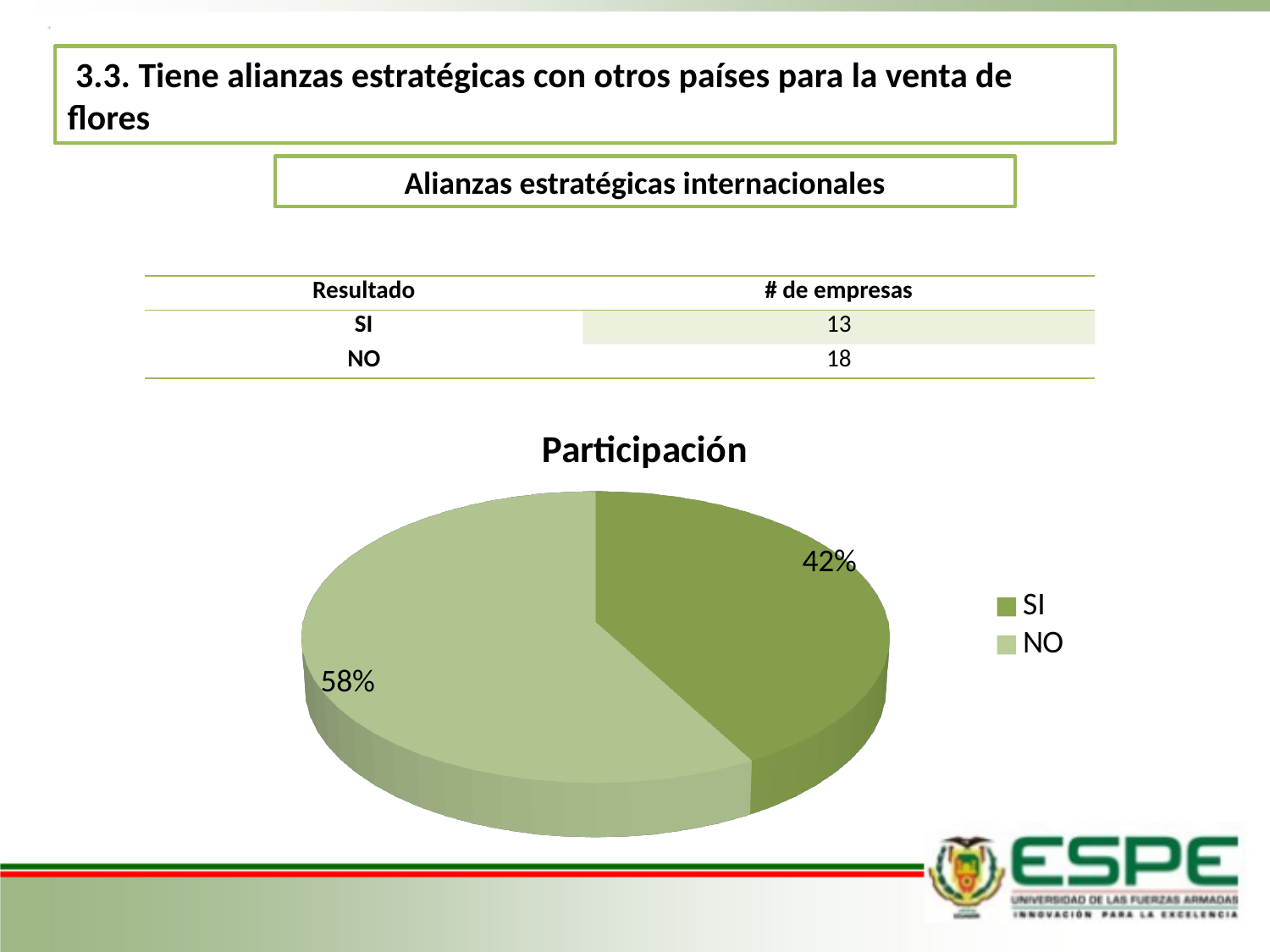
What kind of chart is shown under the title "Participación"? pie chart What share of the pie does the SI slice represent? 42% How many slices does the pie chart have? 2 What share of the pie does the NO slice represent? 58% Is the share for NO greater or less than 50%? greater How many entries does the legend list? 2 Which legend entry is shown in the darker green colour? SI What is the difference in percentage points between the NO slice and the SI slice? 16 percentage points What is the chart's title? Participación Which slice of the pie is the smallest? SI Which slice of the pie is the largest? NO Which slice is larger, SI or NO? NO